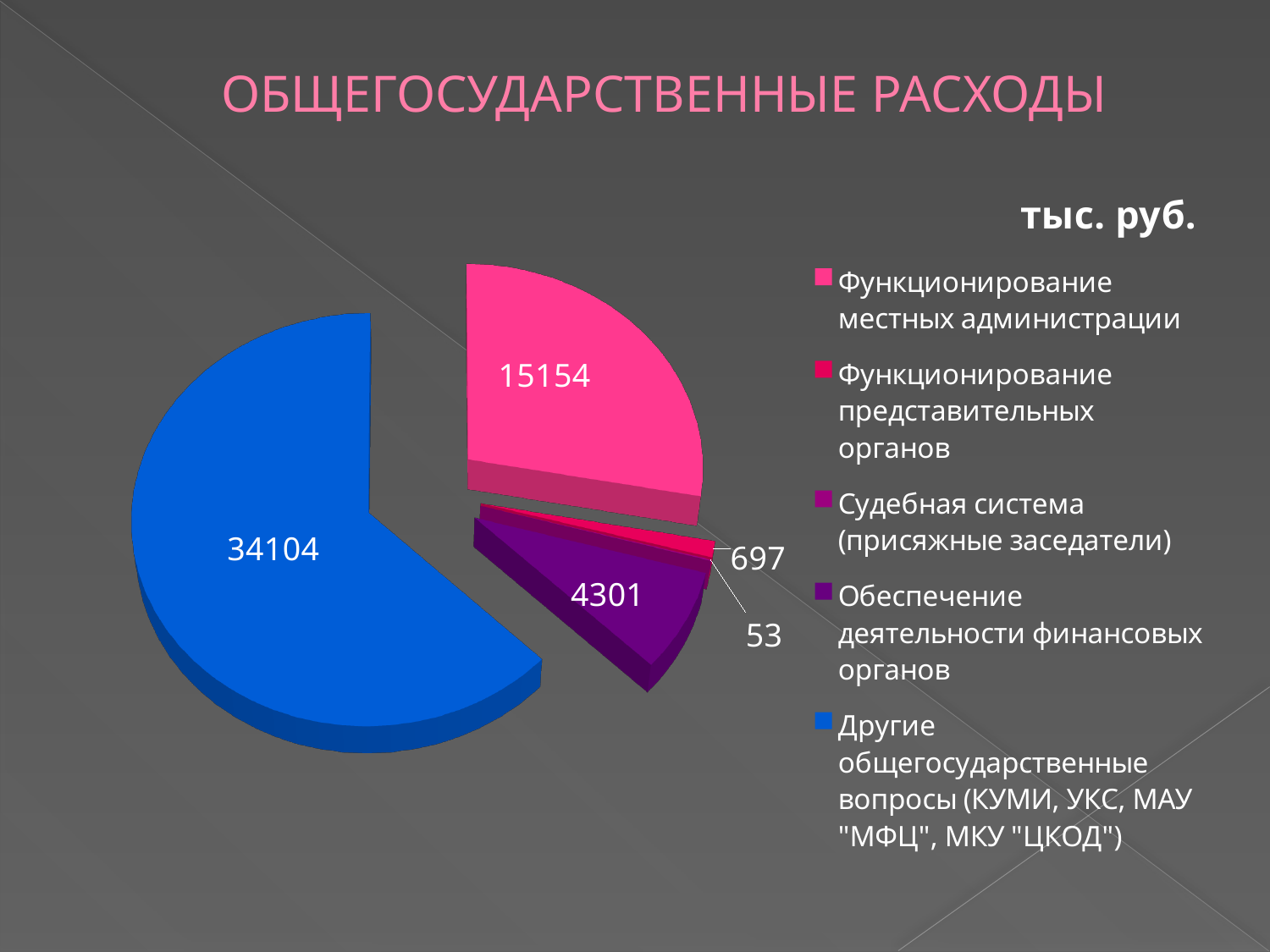
What is the value for Функционирование местных администрации? 15154 What unit is indicated for the values on the chart? тыс. руб. What is the value for Другие общегосударственные вопросы (КУМИ, УКС, МАУ "МФЦ", МКУ "ЦКОД")? 34104 What is the value for Обеспечение деятельности финансовых органов? 4301 What is the value for Судебная система (присяжные заседатели)? 53 What is the difference between the values for Функционирование представительных органов and Судебная система (присяжные заседатели)? 644 What kind of chart is shown on the slide? Pie chart Which category has the smallest slice of the pie? Судебная система (присяжные заседатели) What is the difference between the values for Другие общегосударственные вопросы and Функционирование местных администрации? 18950 How many categories does the pie chart show? 5 Which category has the largest slice of the pie? Другие общегосударственные вопросы (КУМИ, УКС, МАУ "МФЦ", МКУ "ЦКОД") Which is larger: Обеспечение деятельности финансовых органов or Функционирование представительных органов? Обеспечение деятельности финансовых органов